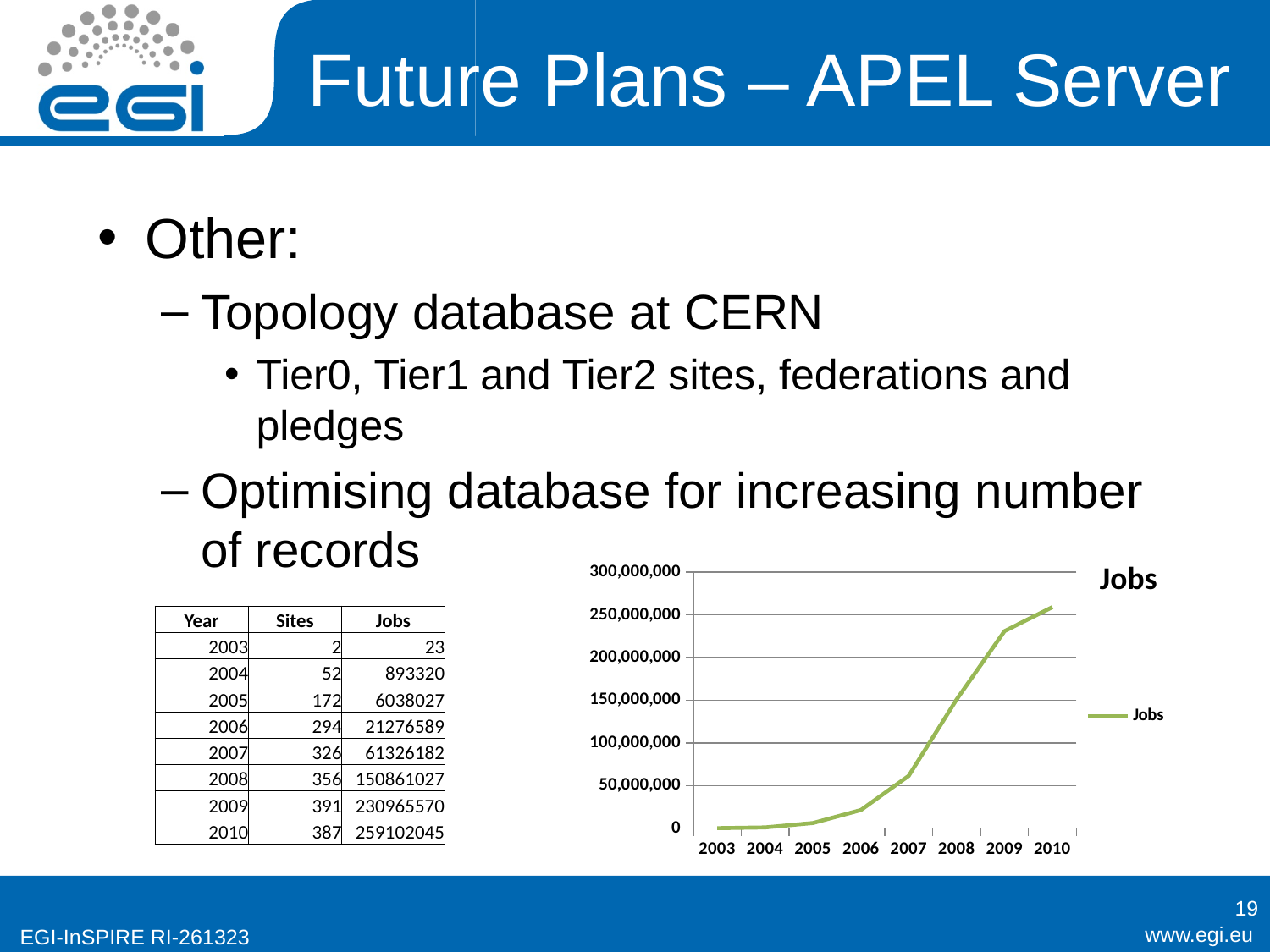
Is the Jobs value for 2009 greater or less than 200,000,000? greater Is the Jobs value for 2007 greater or less than 100,000,000? less Which year has the highest number of Jobs? 2010 What is the title of the chart? Jobs How many series does the chart legend list? 1 Which year has more Jobs, 2006 or 2008? 2008 Do the Jobs values rise or fall from 2003 to 2010? rise How many years are plotted along the x axis of the chart? 8 Is the Jobs value for 2008 greater or less than 100,000,000? greater Which year has the lowest number of Jobs? 2003 According to the table on the slide, how many Jobs were there in 2010? 259102045 What kind of chart is shown on the slide? line chart